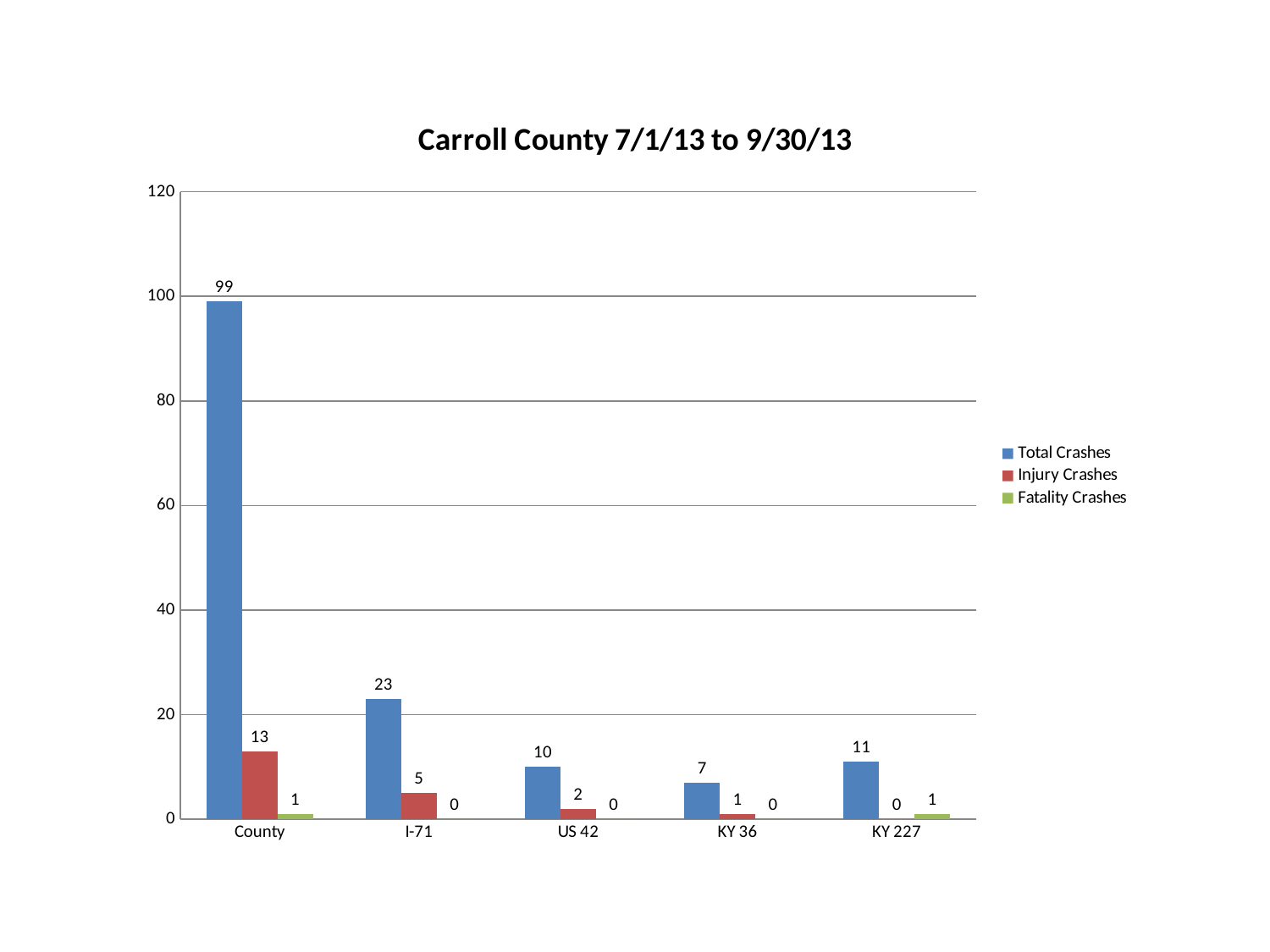
Which is larger, Total Crashes for KY 227 or Total Crashes for US 42? KY 227 Is the value of Total Crashes for County greater or less than 80? greater How many series does the legend list? 3 How many categories are shown on the x axis? 5 What is the title of the chart? Carroll County 7/1/13 to 9/30/13 Which category has the lowest Total Crashes? KY 36 What is the difference between Total Crashes for I-71 and Total Crashes for US 42? 13 What is the value of Injury Crashes for I-71? 5 What kind of chart is shown on the slide? bar chart Which category has the highest Total Crashes? County What is the value of Fatality Crashes for KY 227? 1 What is the value of Total Crashes for County? 99